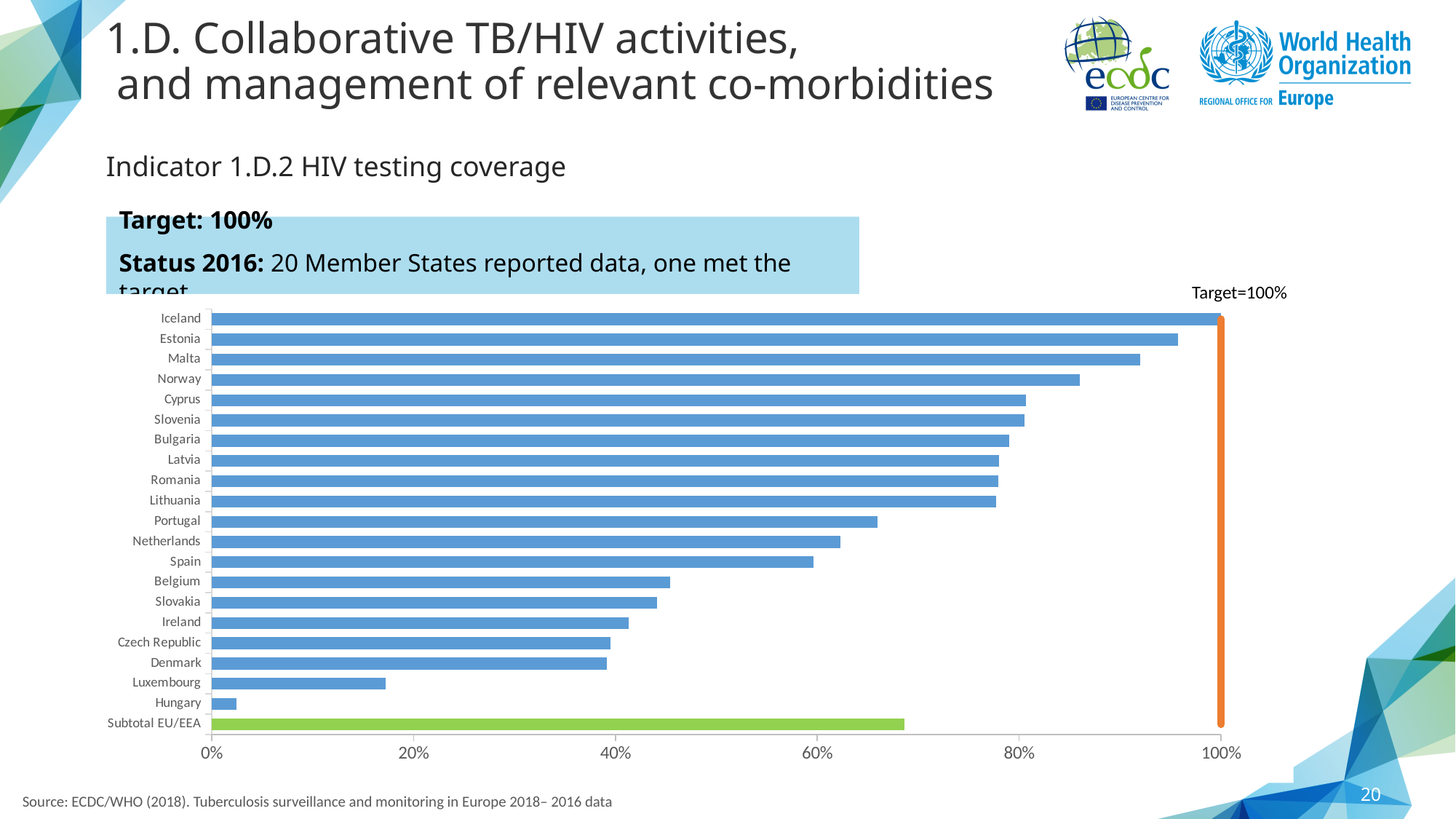
What is the HIV testing coverage value for Iceland? 100% What target value is marked by the vertical orange line in the chart? Target=100% How many bars are plotted in the chart, including the Subtotal EU/EEA bar? 21 What kind of chart is shown on the slide? bar chart Is the value for Hungary greater or less than 20%? less Is the value for Subtotal EU/EEA greater or less than 60%? greater Which country has the lowest HIV testing coverage in the chart? Hungary Is the value for Norway greater or less than 80%? greater Which country has the highest HIV testing coverage in the chart? Iceland Which has the higher HIV testing coverage, Estonia or Malta? Estonia